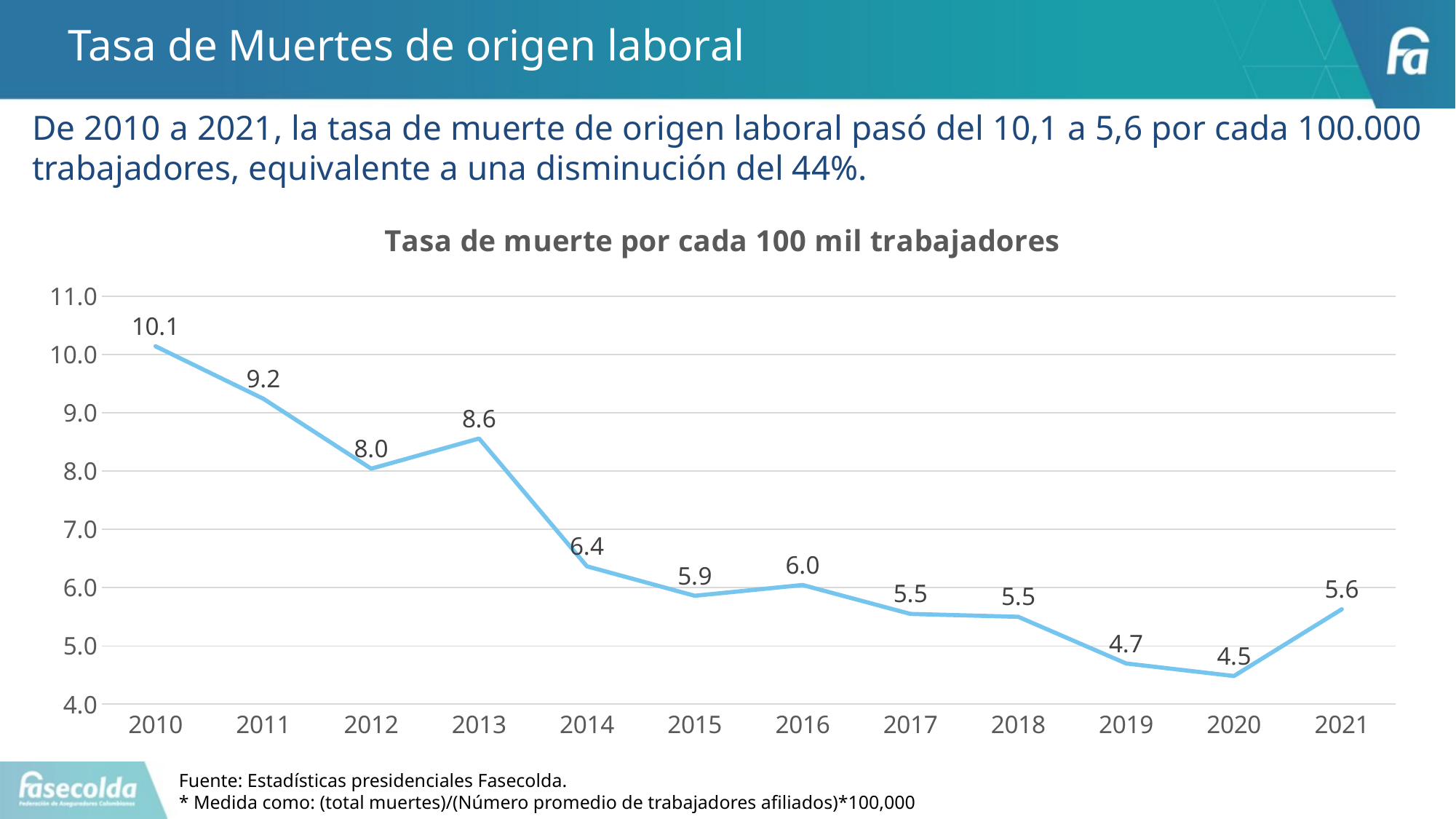
Which year has the highest value? 2010 Do the values generally rise or fall from 2010 to 2020? fall Which year has the lowest value? 2020 What kind of chart is shown? line chart What is the value for 2010? 10.1 What is the value for 2013? 8.6 What is the title of the chart? Tasa de muerte por cada 100 mil trabajadores Is the value for 2014 greater or less than 7.0? less What is the value for 2021? 5.6 What is the difference between the values for 2010 and 2021? 4.5 Which is larger, the value for 2012 or the value for 2013? 2013 How many years are plotted on the chart? 12